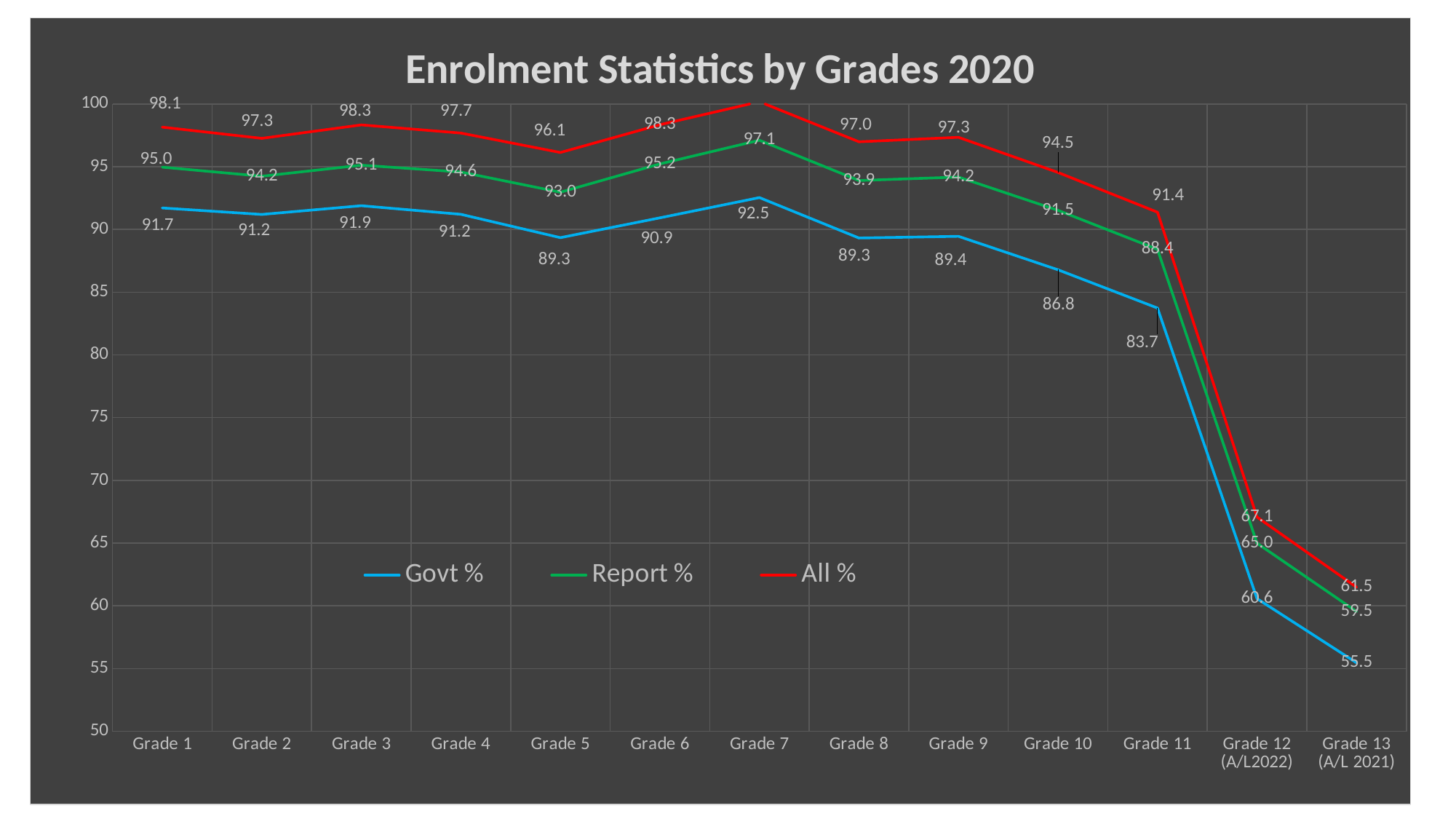
What kind of chart is shown on the slide? Line chart Which is larger for Govt %: Grade 5 or Grade 6? Grade 6 What is the Govt % value for Grade 7? 92.5 Which grade has the lowest Govt % value? Grade 13 (A/L 2021) How many series does the legend list? 3 What is the All % value for Grade 13 (A/L 2021)? 61.5 How many grades are plotted along the x axis? 13 Is the Govt % value for Grade 12 (A/L2022) greater or less than 65? less Which grade has the highest Report % value? Grade 7 What is the Report % value for Grade 11? 88.4 What is the difference between the All % and Govt % values for Grade 1? 6.4 Do the All % values rise or fall from Grade 11 to Grade 13? fall